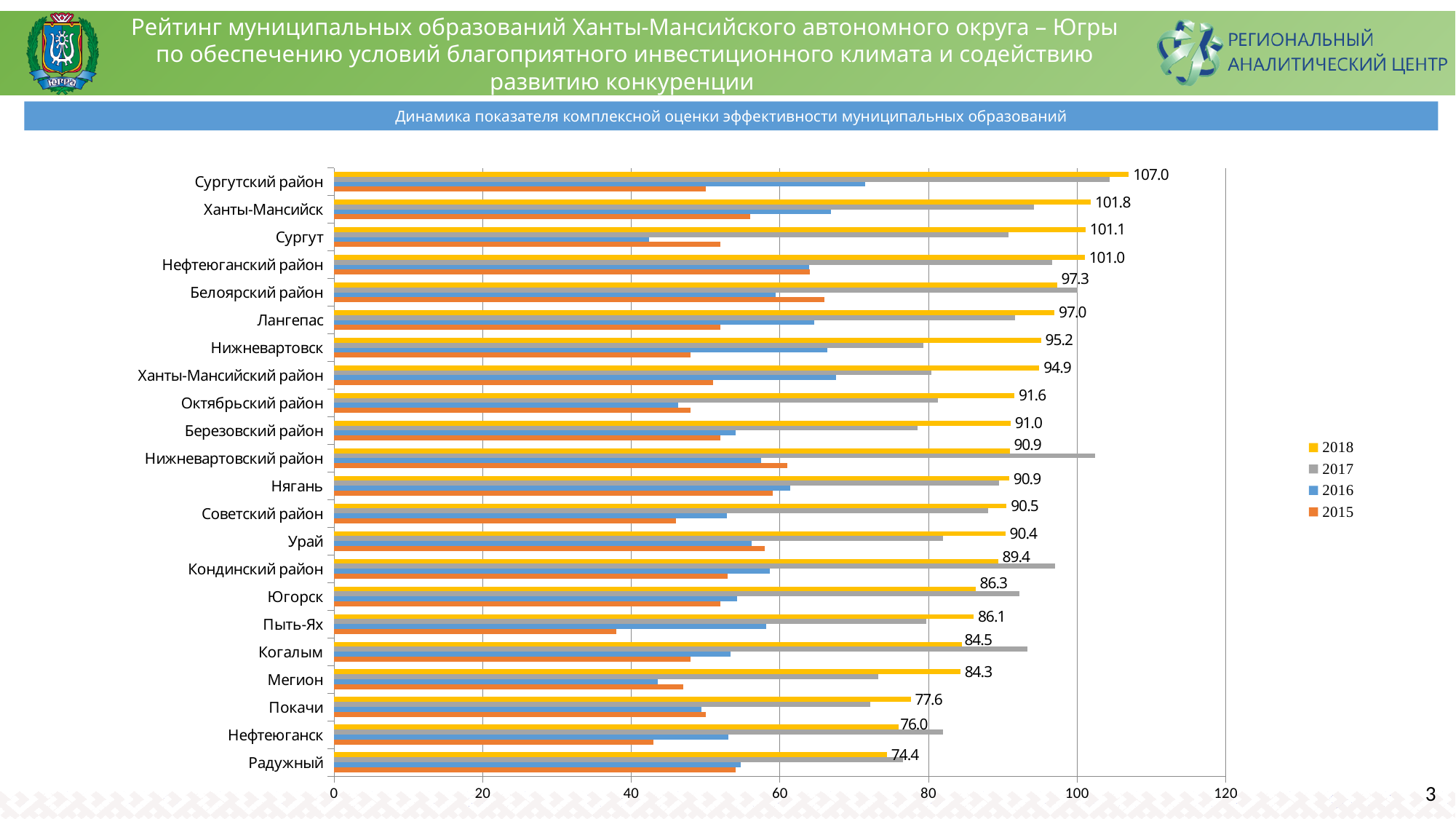
What is the difference between the 2018 values for Сургутский район and Радужный? 32.6 What is the 2018 value for Сургутский район? 107.0 Which municipality has the highest 2018 value? Сургутский район What is the 2018 value for Радужный? 74.4 Which municipality has the lowest 2018 value? Радужный How many municipalities are shown on the chart? 22 How many series does the legend list? 4 What is the 2018 value for Лангепас? 97.0 Which has the larger 2018 value, Нижневартовск or Югорск? Нижневартовск Is the 2017 value for Нижневартовский район greater or less than 100? greater What kind of chart is shown on the slide? Bar chart Is the 2015 value for Пыть-Ях greater or less than 40? less